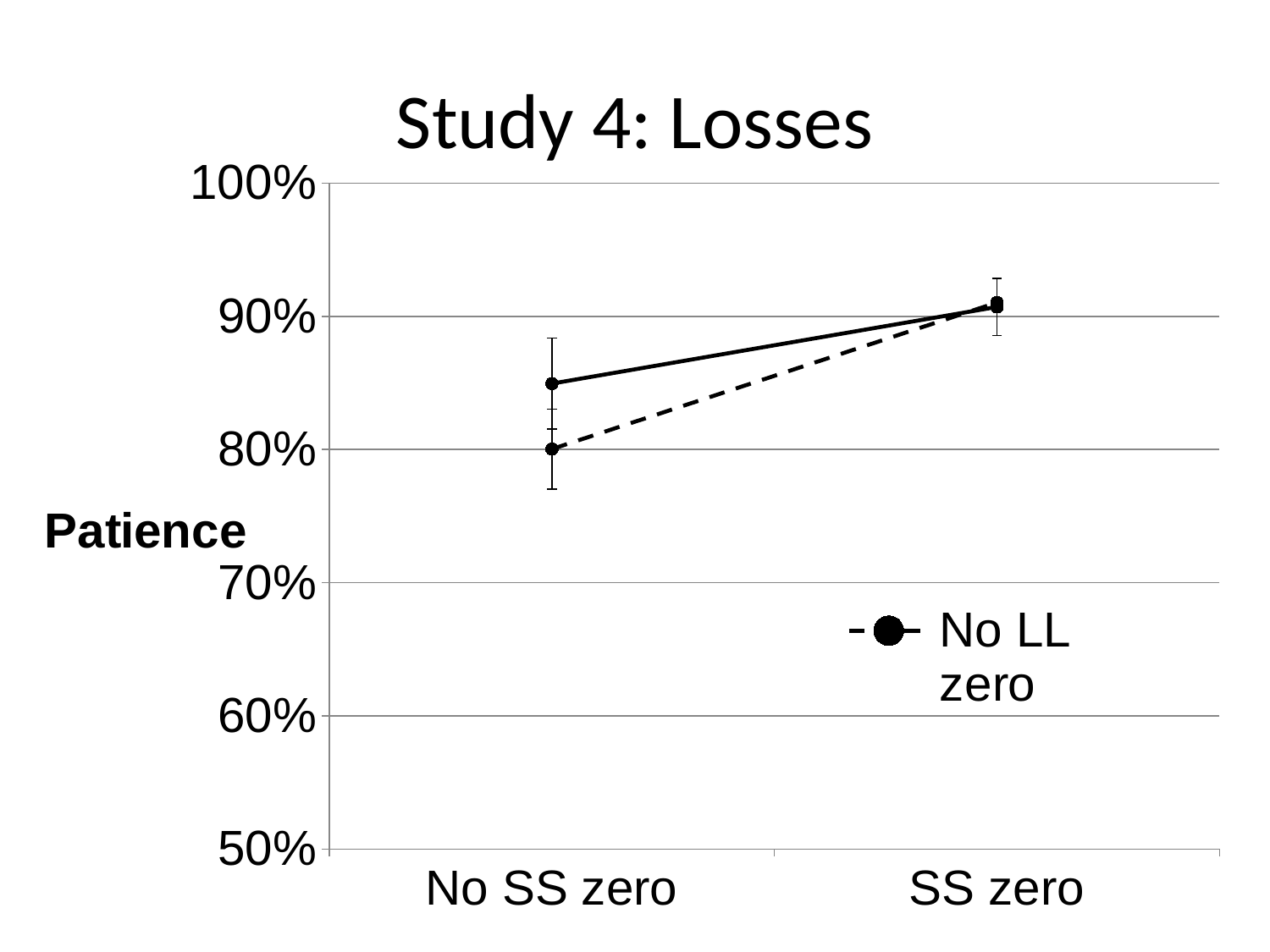
What is the label on the vertical axis of the chart? Patience Is the value for No LL zero at SS zero greater or less than 80%? greater How many categories are shown on the x axis? 2 How many series does the legend list? 1 Is the value for No LL zero at No SS zero greater or less than 90%? less At No SS zero, which line has the higher value, the solid line or the dashed No LL zero line? the solid line What is the title of the chart? Study 4: Losses Is the value for No LL zero at No SS zero greater or less than 70%? greater For the No LL zero series, which category has the higher value, No SS zero or SS zero? SS zero What is the lowest value shown on the vertical axis? 50% What kind of chart is shown on the slide? line chart Does the No LL zero series rise or fall from No SS zero to SS zero? rise